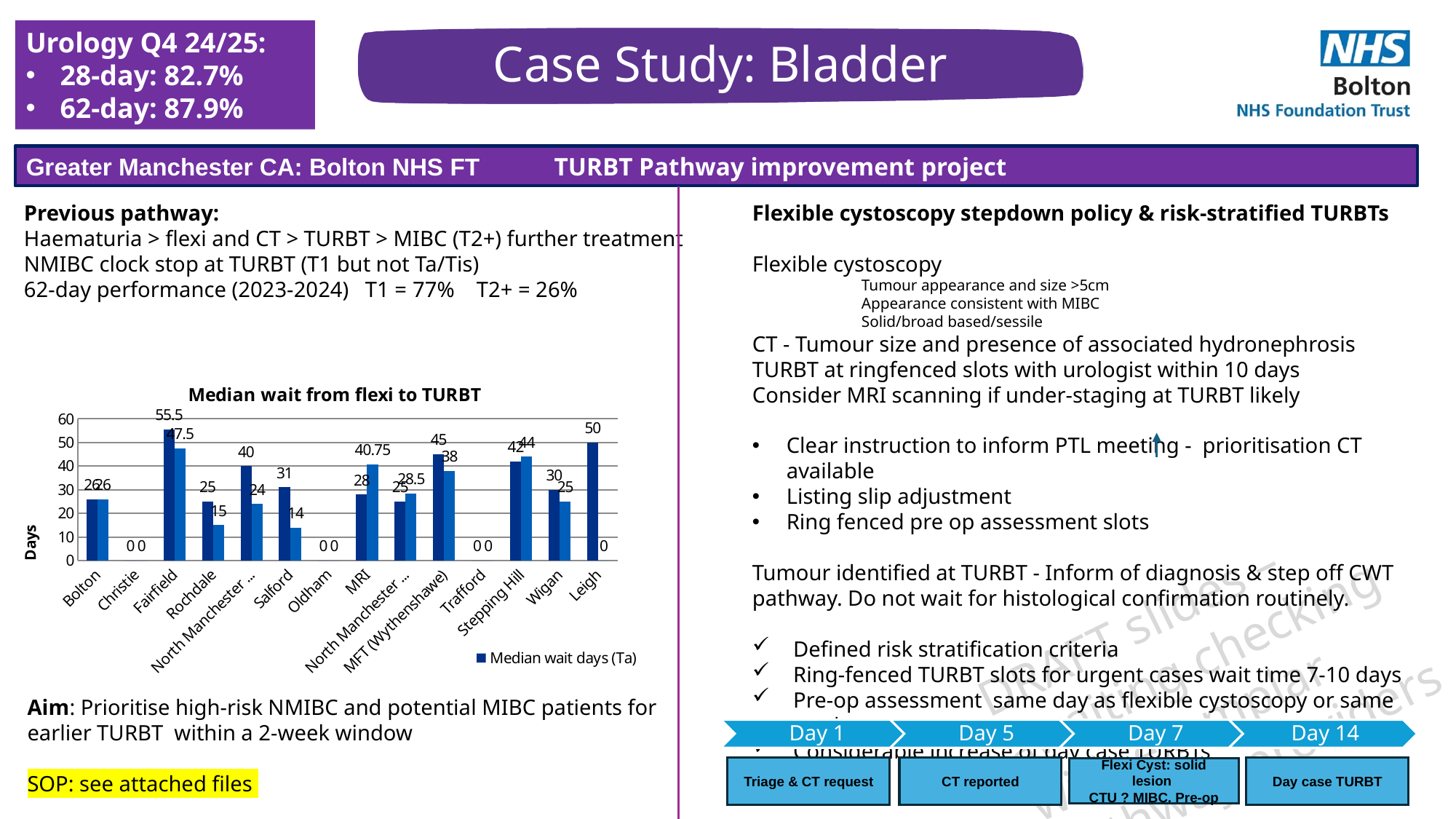
What is the legend entry shown on the 'Median wait from flexi to TURBT' chart? Median wait days (Ta) What is the y-axis label of the 'Median wait from flexi to TURBT' chart? Days What kind of chart is 'Median wait from flexi to TURBT'? bar chart In the 'Median wait from flexi to TURBT' chart, what is the Median wait days (Ta) value for Rochdale? 25 In the 'Median wait from flexi to TURBT' chart, what is the Median wait days (Ta) value for Leigh? 50 In the 'Median wait from flexi to TURBT' chart, which site has the highest Median wait days (Ta)? Fairfield In the 'Median wait from flexi to TURBT' chart, what is the Median wait days (Ta) value for Fairfield? 55.5 How many sites are shown on the x axis of the 'Median wait from flexi to TURBT' chart? 14 In the 'Median wait from flexi to TURBT' chart, which has the larger Median wait days (Ta): MFT (Wythenshawe) or Stepping Hill? MFT (Wythenshawe) How many series does the legend of the 'Median wait from flexi to TURBT' chart list? 1 In the 'Median wait from flexi to TURBT' chart, is the Median wait days (Ta) for Bolton greater or less than 20? greater In the 'Median wait from flexi to TURBT' chart, what is the difference between the Median wait days (Ta) for Fairfield and Leigh? 5.5